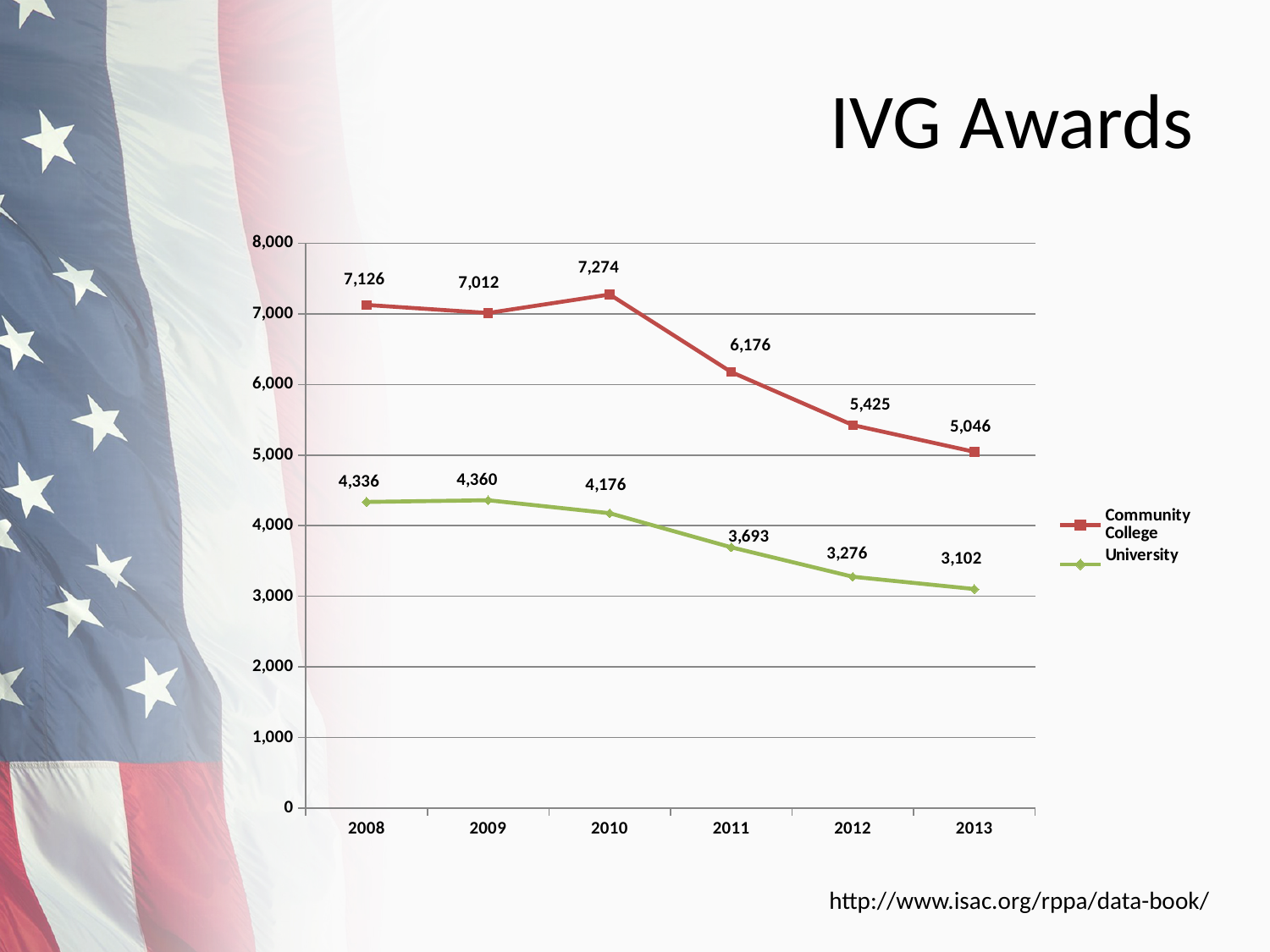
What is the difference between the Community College and University values in 2008? 2,790 How many years are shown on the x axis? 6 What was the Community College value in 2010? 7,274 What was the University value in 2013? 3,102 What kind of chart is shown on the slide? Line chart In which year was the University series highest? 2009 Which was larger in 2011, the Community College value or the University value? Community College By how much did the Community College value fall from 2010 to 2013? 2,228 Does the University series rise or fall from 2010 to 2013? Fall How many series does the legend list? 2 In which year was the Community College series lowest? 2013 What was the Community College value in 2012? 5,425